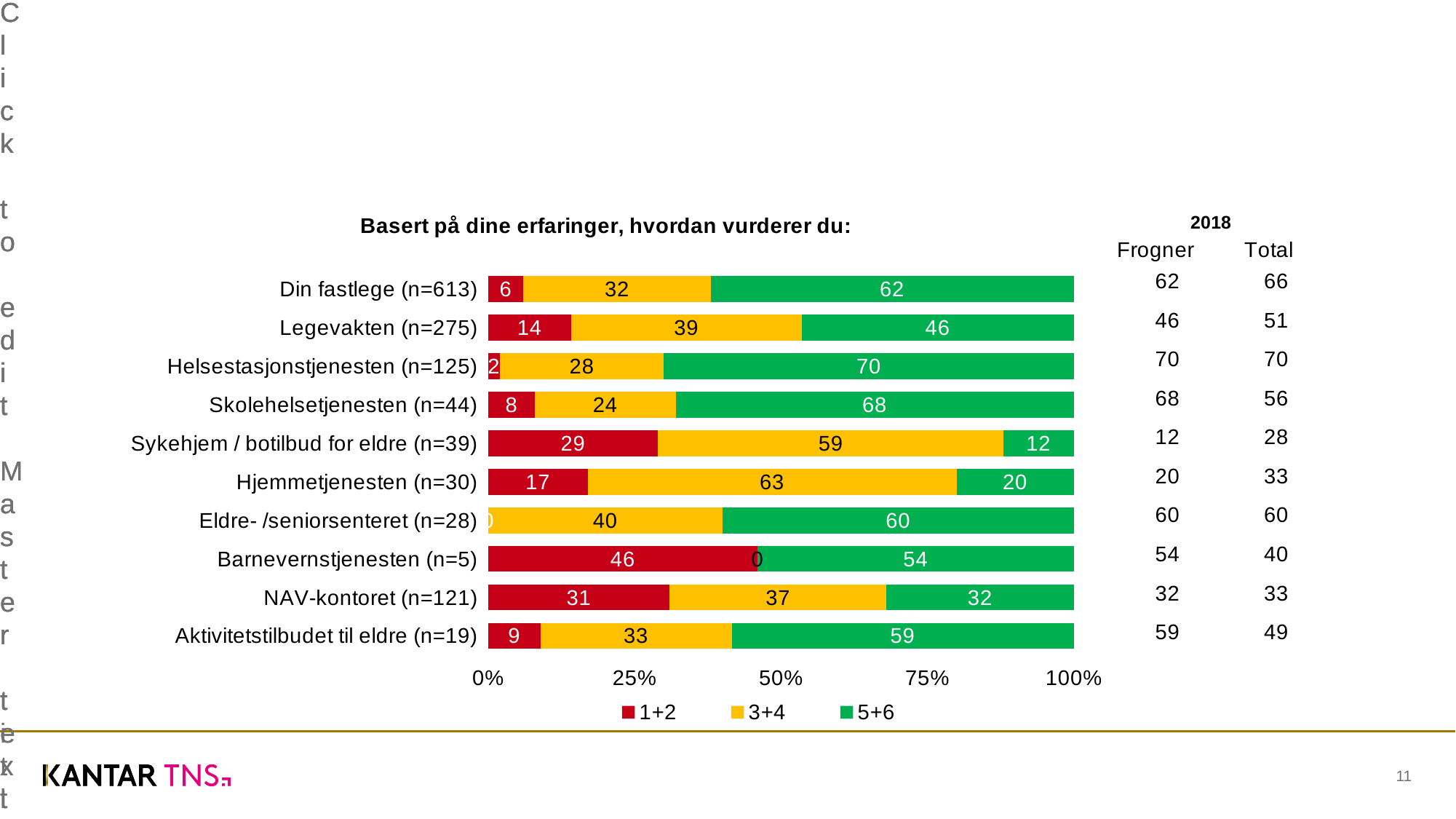
Which has a larger 5+6 value: Skolehelsetjenesten (n=44) or Legevakten (n=275)? Skolehelsetjenesten (n=44) What is the difference between the 5+6 value and the 1+2 value for Din fastlege (n=613)? 56 What kind of chart is shown on the slide? Stacked bar chart What is the title of the chart? Basert på dine erfaringer, hvordan vurderer du: How many series does the legend list? 3 What is the value of the 3+4 series for Hjemmetjenesten (n=30)? 63 How many categories are shown on the chart? 10 Which category has the lowest value in the 5+6 series? Sykehjem / botilbud for eldre (n=39) Which category has the highest value in the 1+2 series? Barnevernstjenesten (n=5) What is the value of the 5+6 series for Din fastlege (n=613)? 62 Which category has the highest value in the 5+6 series? Helsestasjonstjenesten (n=125) What is the value of the 1+2 series for NAV-kontoret (n=121)? 31